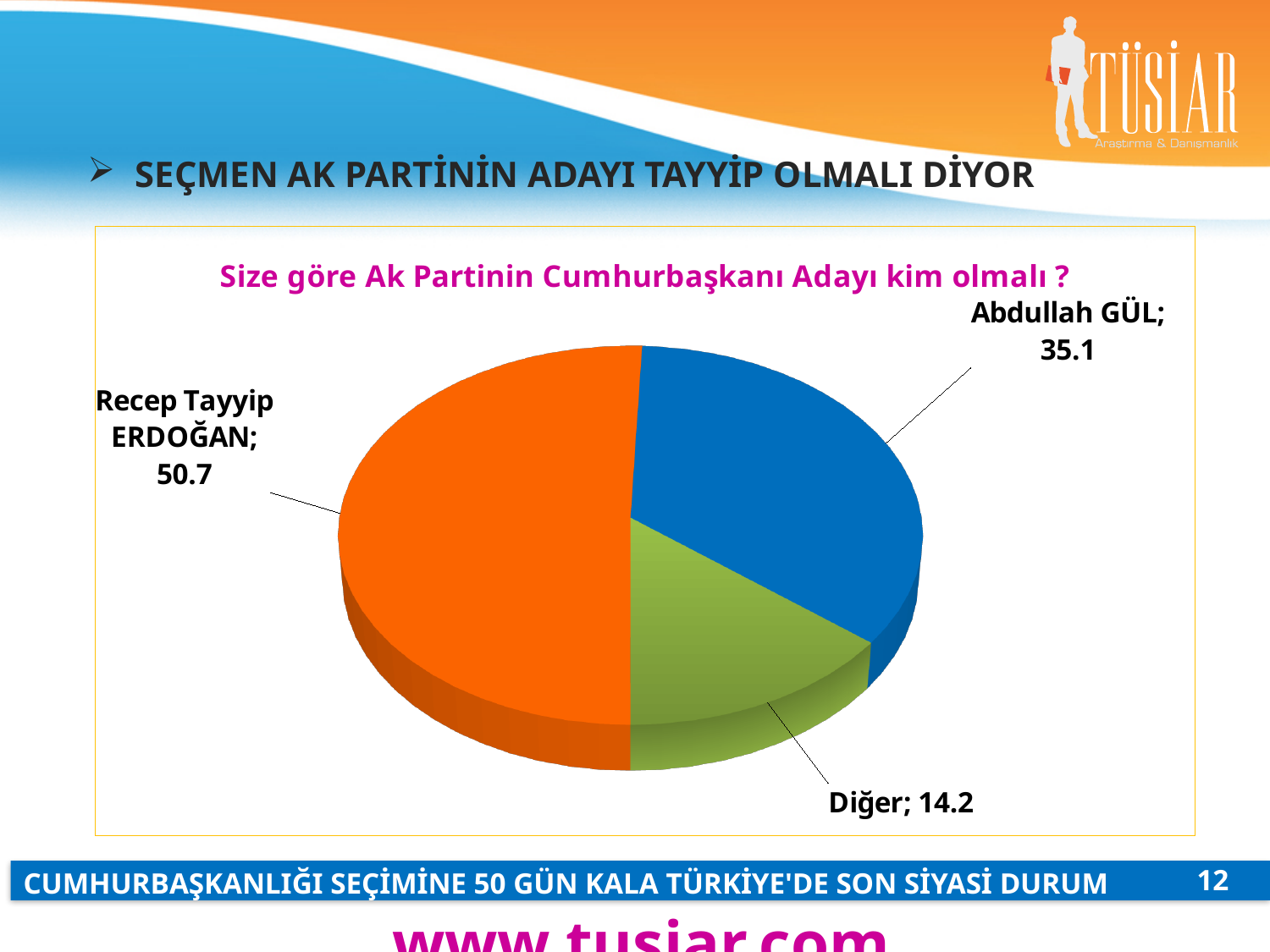
What is the value for Diğer? 14.2 What kind of chart is shown on the slide? Pie chart What is the value for Recep Tayyip ERDOĞAN? 50.7 What colour is the slice for Recep Tayyip ERDOĞAN? Orange How many slices does the pie chart have? 3 What is the difference between the values for Recep Tayyip ERDOĞAN and Abdullah GÜL? 15.6 Which is larger, the value for Abdullah GÜL or the value for Diğer? Abdullah GÜL Which category has the smallest slice? Diğer What is the value for Abdullah GÜL? 35.1 Which category has the largest slice? Recep Tayyip ERDOĞAN What is the difference between the values for Abdullah GÜL and Diğer? 20.9 What is the title of the chart? Size göre Ak Partinin Cumhurbaşkanı Adayı kim olmalı ?